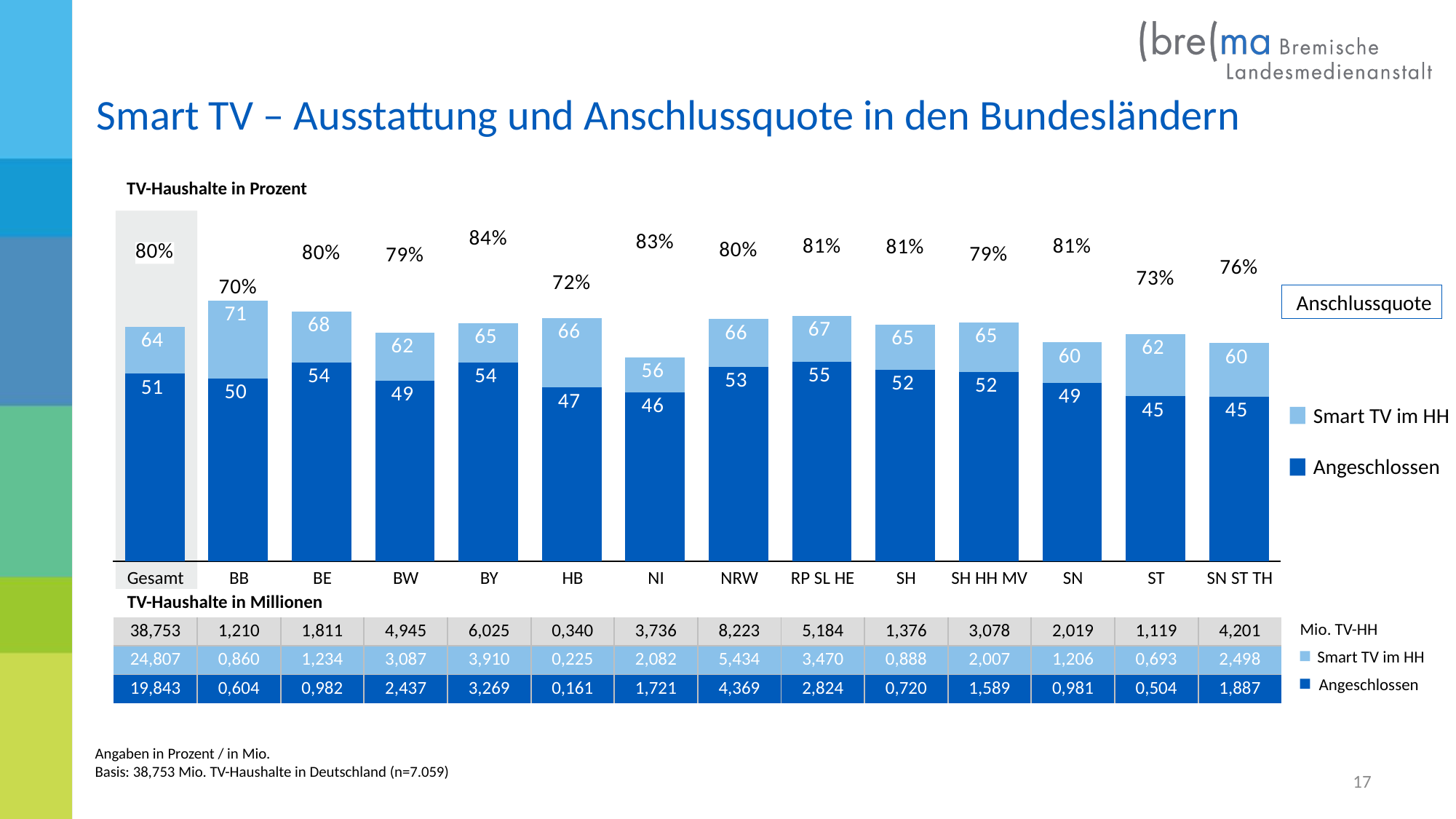
What is the Anschlussquote shown above the bar for BY? 84% Which is larger, the Angeschlossen value for BE or for HB? BE How many series does the chart legend list? 2 What kind of chart is shown on the slide? bar chart What is the Smart TV im HH value for BB? 71 What is the Angeschlossen value for NRW? 53 Which category has the highest Angeschlossen value? RP SL HE Which category has the highest Smart TV im HH value? BB What is the difference between the Smart TV im HH value and the Angeschlossen value for BB? 21 How many categories are shown on the x axis of the chart? 14 Which category has the lowest Anschlussquote? BB Which category has the lowest Smart TV im HH value? NI